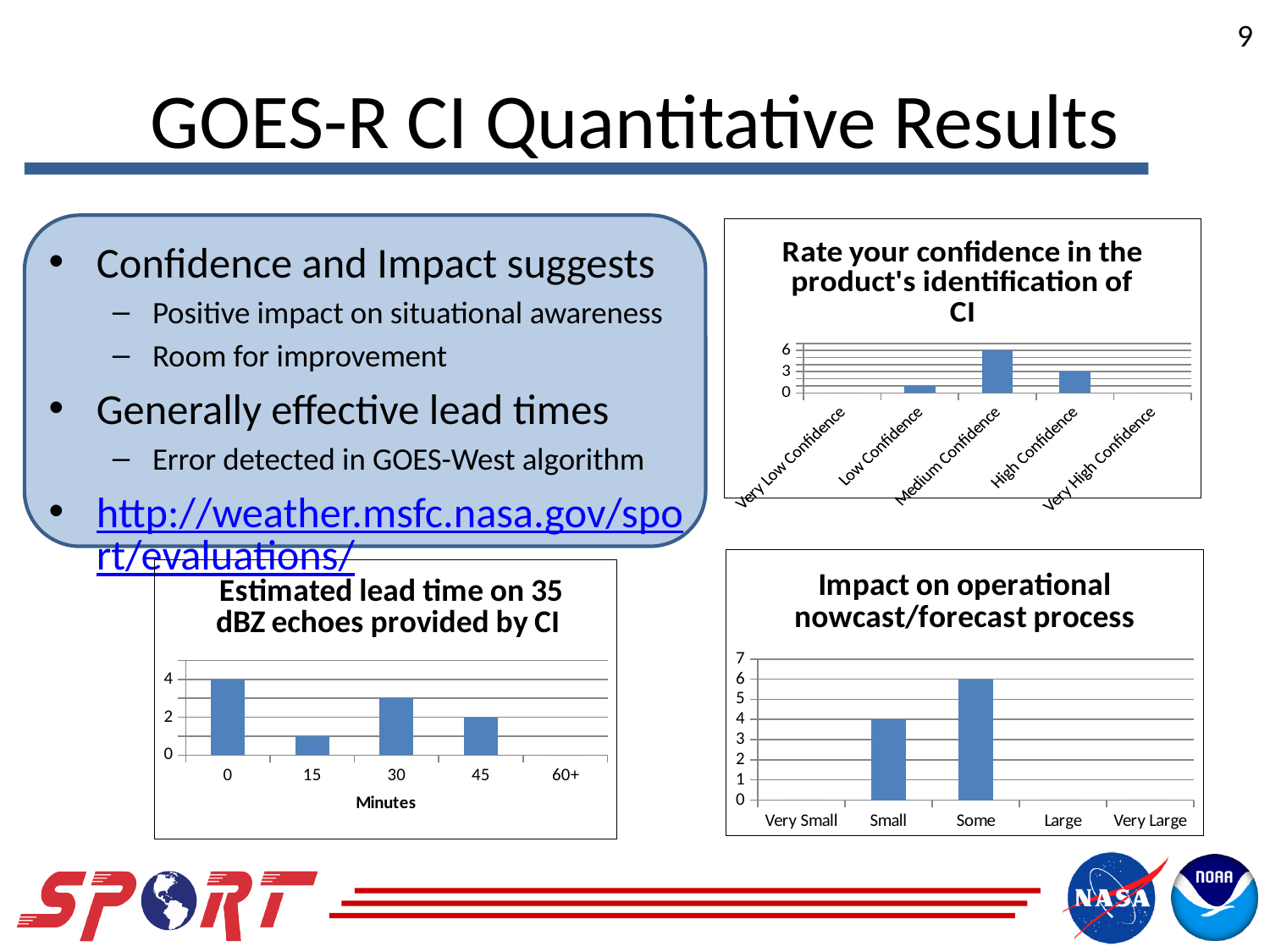
In the chart titled "Impact on operational nowcast/forecast process", how many categories are shown on the x axis? 5 In the chart titled "Impact on operational nowcast/forecast process", which category has the highest value? Some In the chart titled "Impact on operational nowcast/forecast process", what is the value for Small? 4 In the chart titled "Impact on operational nowcast/forecast process", what is the value for Some? 6 In the chart titled "Estimated lead time on 35 dBZ echoes provided by CI", what is the value for 0 minutes? 4 In the chart titled "Impact on operational nowcast/forecast process", what is the difference between the values for Some and Small? 2 What kind of chart is the one titled "Estimated lead time on 35 dBZ echoes provided by CI"? Bar chart In the chart titled "Estimated lead time on 35 dBZ echoes provided by CI", is the value for 15 minutes greater or less than 2? less In the chart titled "Rate your confidence in the product's identification of CI", what is the value for High Confidence? 3 In the chart titled "Estimated lead time on 35 dBZ echoes provided by CI", which of 30 or 45 minutes has the larger value? 30 In the chart titled "Rate your confidence in the product's identification of CI", is the value for Low Confidence greater or less than 3? less In the chart titled "Rate your confidence in the product's identification of CI", which category has the highest value? Medium Confidence